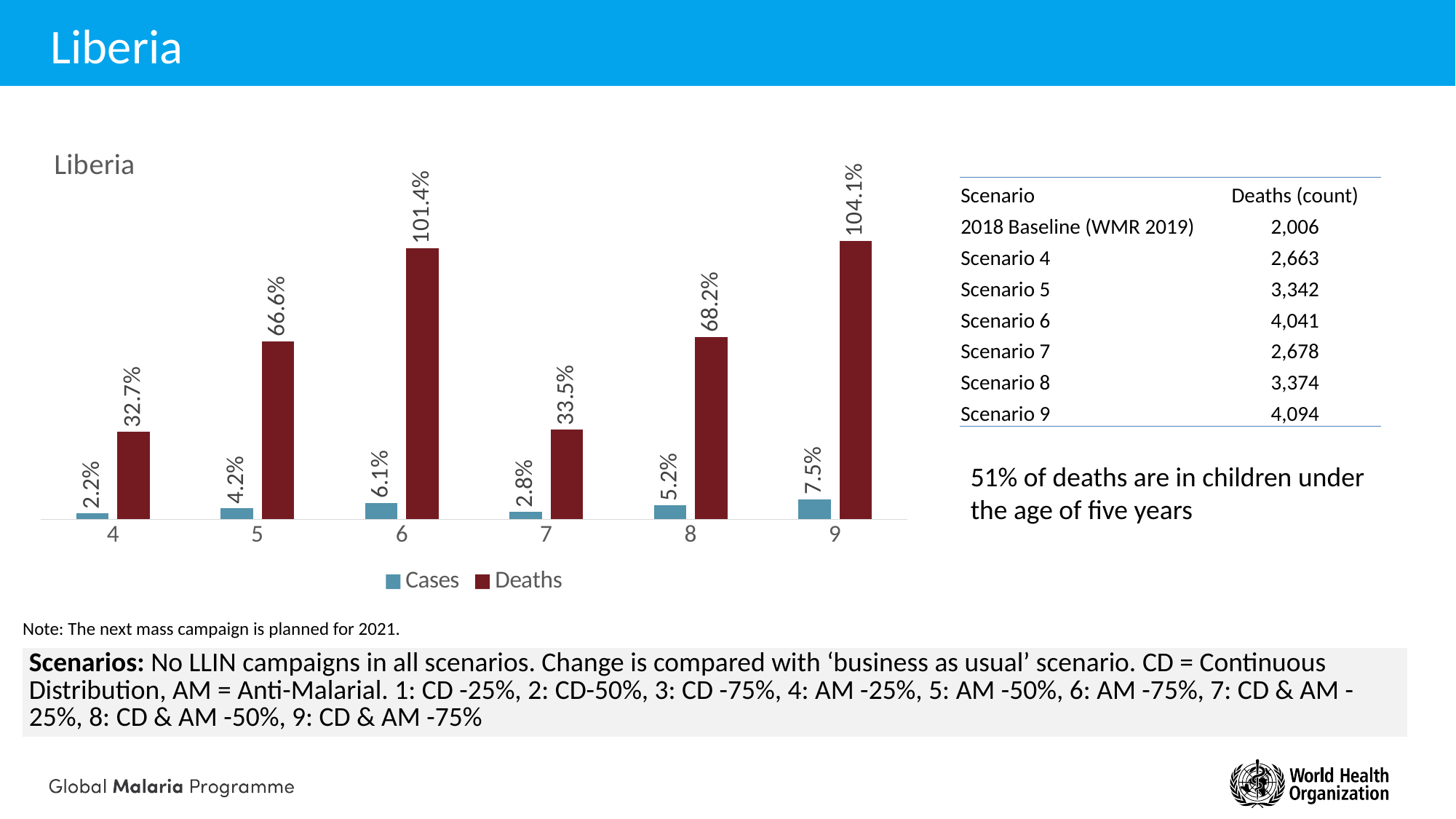
What is the Cases value for scenario 9? 7.5% Which is larger, the Deaths value for scenario 5 or for scenario 8? Scenario 8 Which scenario has the lowest Cases value? 4 How many series does the chart legend list? 2 How many scenarios are shown on the x axis of the chart? 6 What is the difference between the Deaths values for scenario 9 and scenario 6? 2.7% Which scenario has the highest Deaths value? 9 What colour are the Deaths bars in the chart? Dark red What is the difference between the Cases values for scenario 8 and scenario 7? 2.4% What is the Deaths value for scenario 6? 101.4% What is the Cases value for scenario 4? 2.2% What kind of chart is shown on the slide? Bar chart